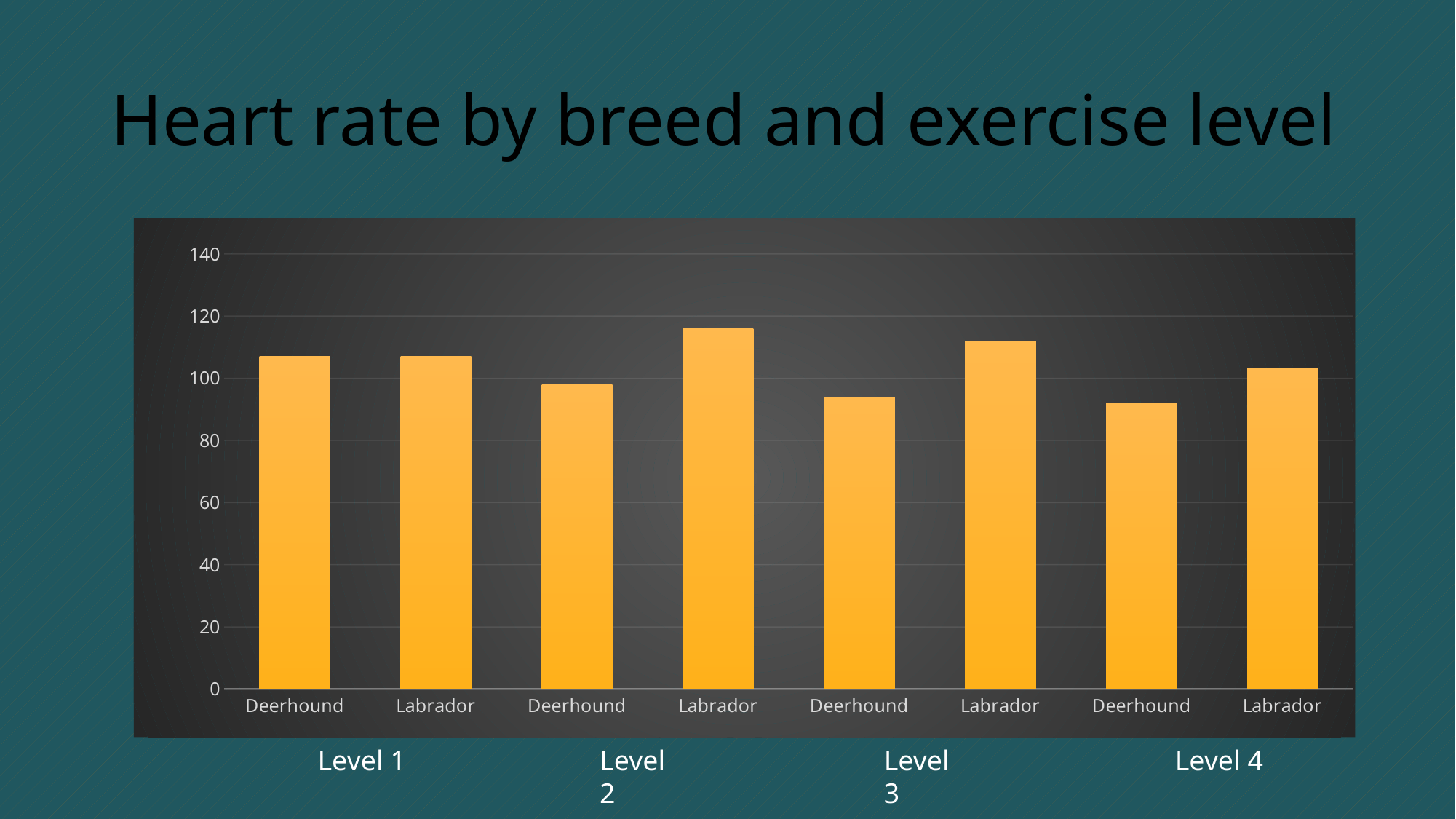
Is the value for Deerhound at Level 4 greater or less than 100? less Which bar is the highest in the chart? Labrador at Level 2 How many bars are plotted in the chart? 8 What colour are the bars in the chart? orange At Level 4, which breed has the higher heart rate, Deerhound or Labrador? Labrador Is the value for Labrador at Level 2 greater or less than 100? greater At Level 2, which breed has the higher heart rate, Deerhound or Labrador? Labrador What kind of chart is shown on the slide? bar chart Do the Deerhound values rise or fall as the exercise level goes from Level 1 to Level 4? fall Is the value for Labrador at Level 3 greater or less than 120? less What is the title of the chart? Heart rate by breed and exercise level How many exercise levels are shown along the x axis? 4